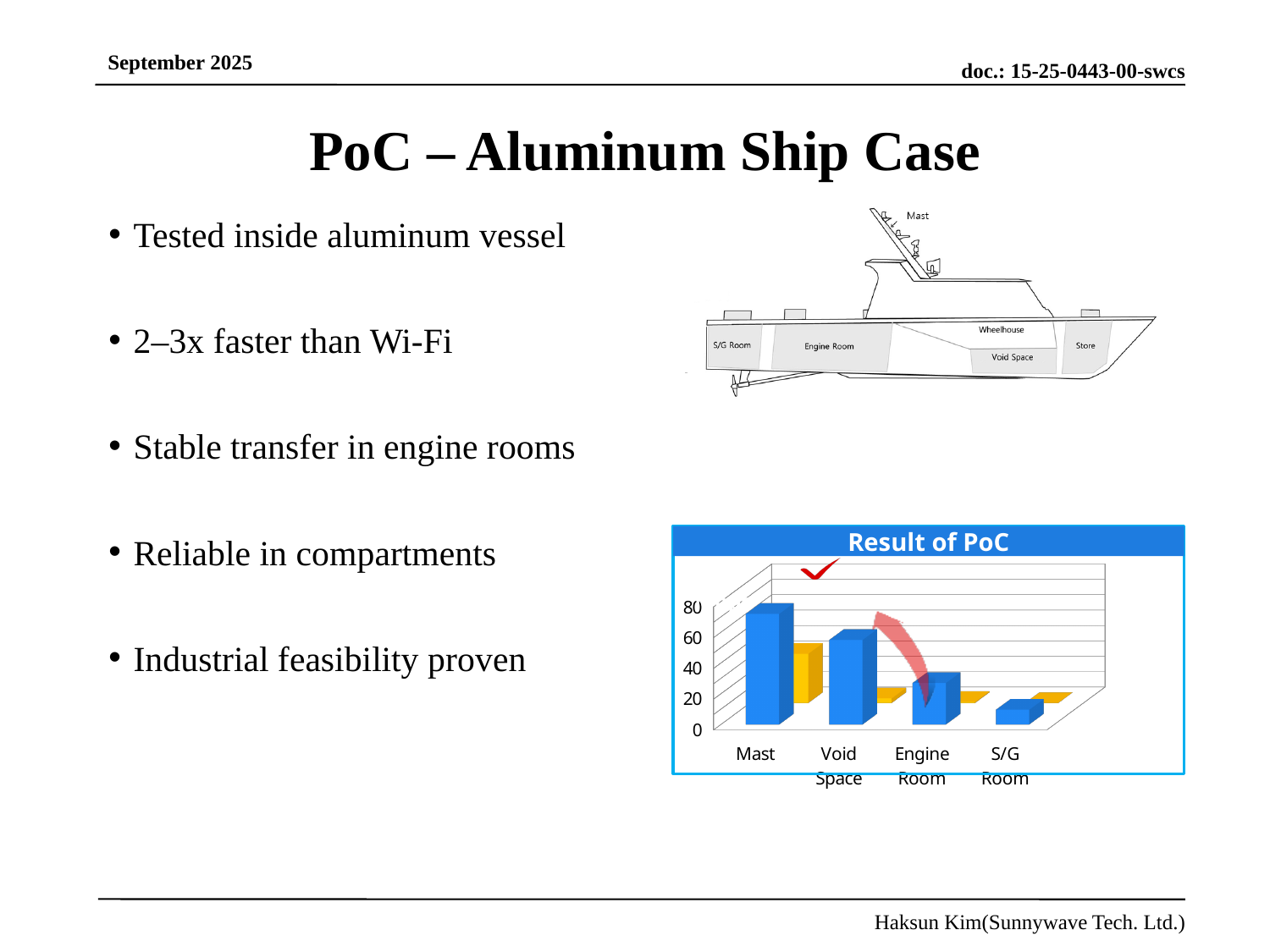
Is the blue bar for Mast greater or less than 60 in the "Result of PoC" chart? greater What colour is the tallest bar in the "Result of PoC" chart? blue How many categories are shown on the x axis of the "Result of PoC" chart? 4 What kind of chart is shown under the title "Result of PoC"? bar chart Is the blue bar for Engine Room greater or less than 60 in the "Result of PoC" chart? less What is the title of the chart on the slide? Result of PoC Is the blue bar for Void Space greater or less than 40 in the "Result of PoC" chart? greater Do the blue bars rise or fall from Mast to S/G Room in the "Result of PoC" chart? fall Which category has the shortest blue bar in the "Result of PoC" chart? S/G Room In the "Result of PoC" chart, which has the taller blue bar, Mast or Engine Room? Mast Which category has the tallest blue bar in the "Result of PoC" chart? Mast